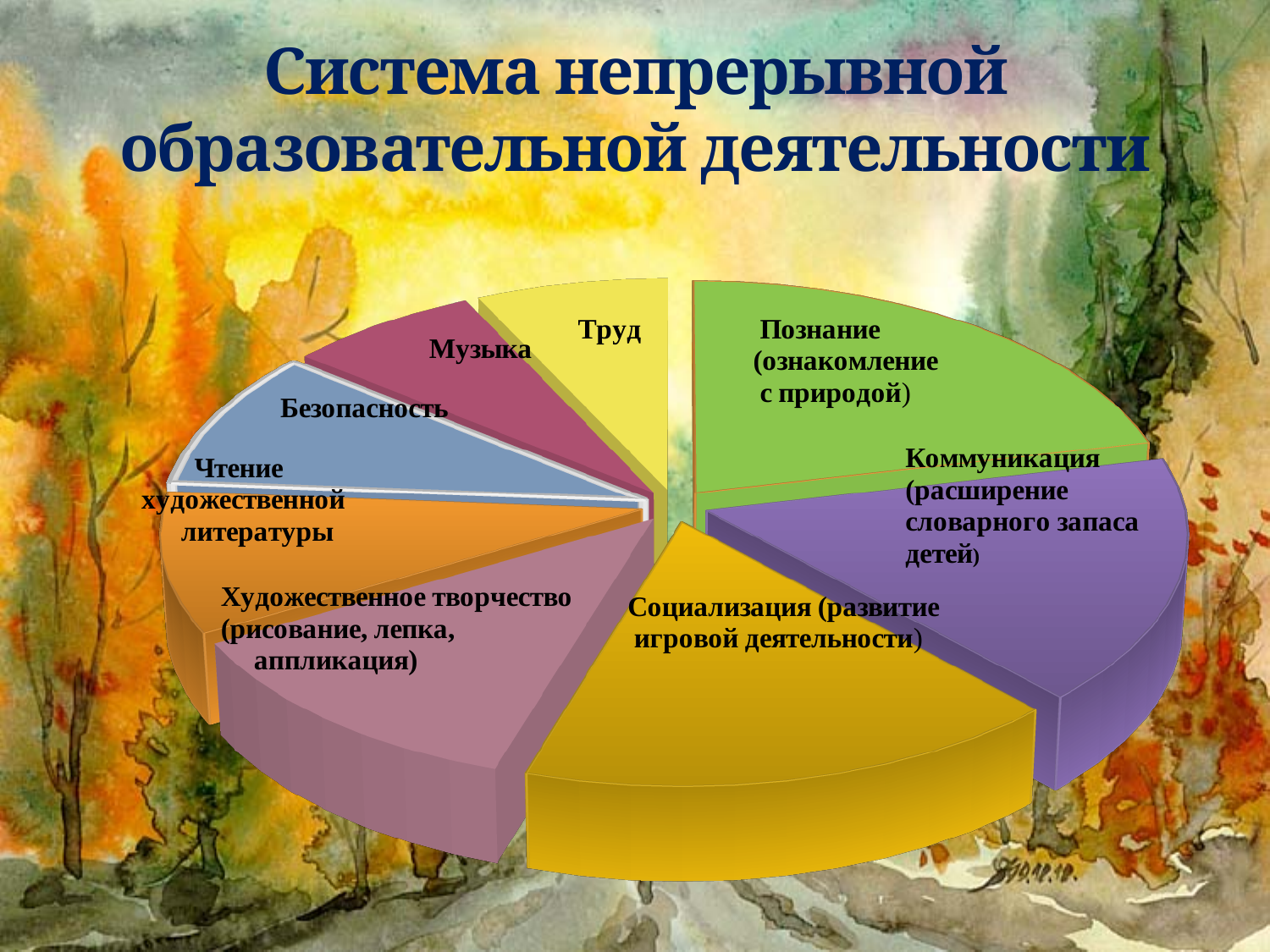
Which slice is larger: Музыка or Социализация (развитие игровой деятельности)? Социализация (развитие игровой деятельности) What kind of chart is shown on the slide? pie chart Which slice is larger: Безопасность or Коммуникация (расширение словарного запаса детей)? Коммуникация (расширение словарного запаса детей) Which slice of the pie chart is the largest? Познание (ознакомление с природой) Which slice is larger: Чтение художественной литературы or Художественное творчество (рисование, лепка, аппликация)? Художественное творчество (рисование, лепка, аппликация) What is the title of the slide containing the pie chart? Система непрерывной образовательной деятельности What colour is the slice labelled Познание (ознакомление с природой)? green How many slices does the pie chart have? 8